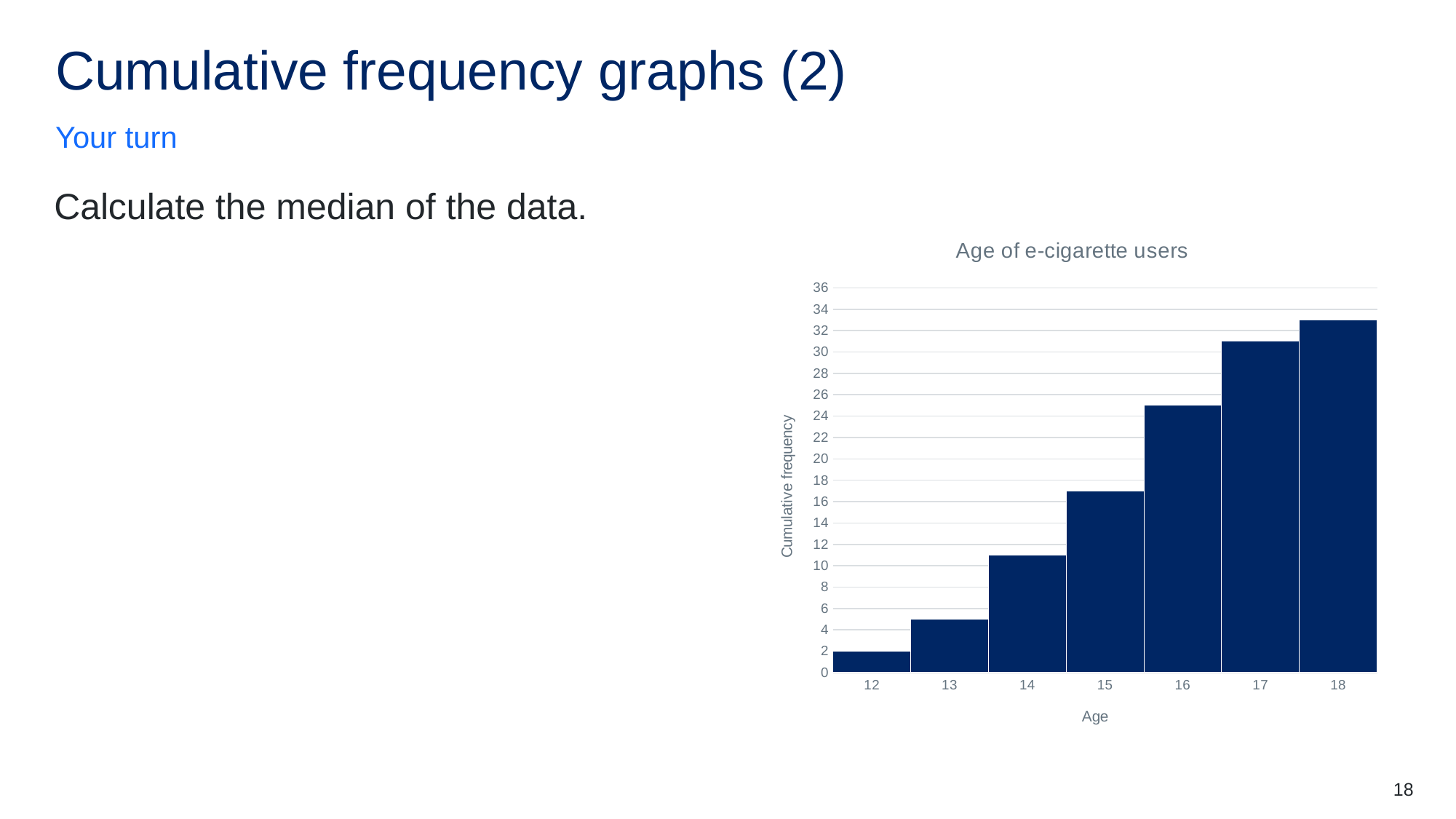
What is the title of the chart? Age of e-cigarette users How many age categories are shown on the x axis? 7 Which has the larger cumulative frequency, age 15 or age 16? 16 Is the cumulative frequency for age 14 greater or less than 12? less Do the cumulative frequency values rise or fall as age increases along the x axis? rise Which age has the lowest cumulative frequency? 12 Which age has the highest cumulative frequency? 18 Is the cumulative frequency for age 17 greater or less than 30? greater What is the cumulative frequency for age 12? 2 Is the cumulative frequency for age 16 greater or less than 24? greater What type of chart is shown on the slide? bar chart What is the label of the vertical axis? Cumulative frequency